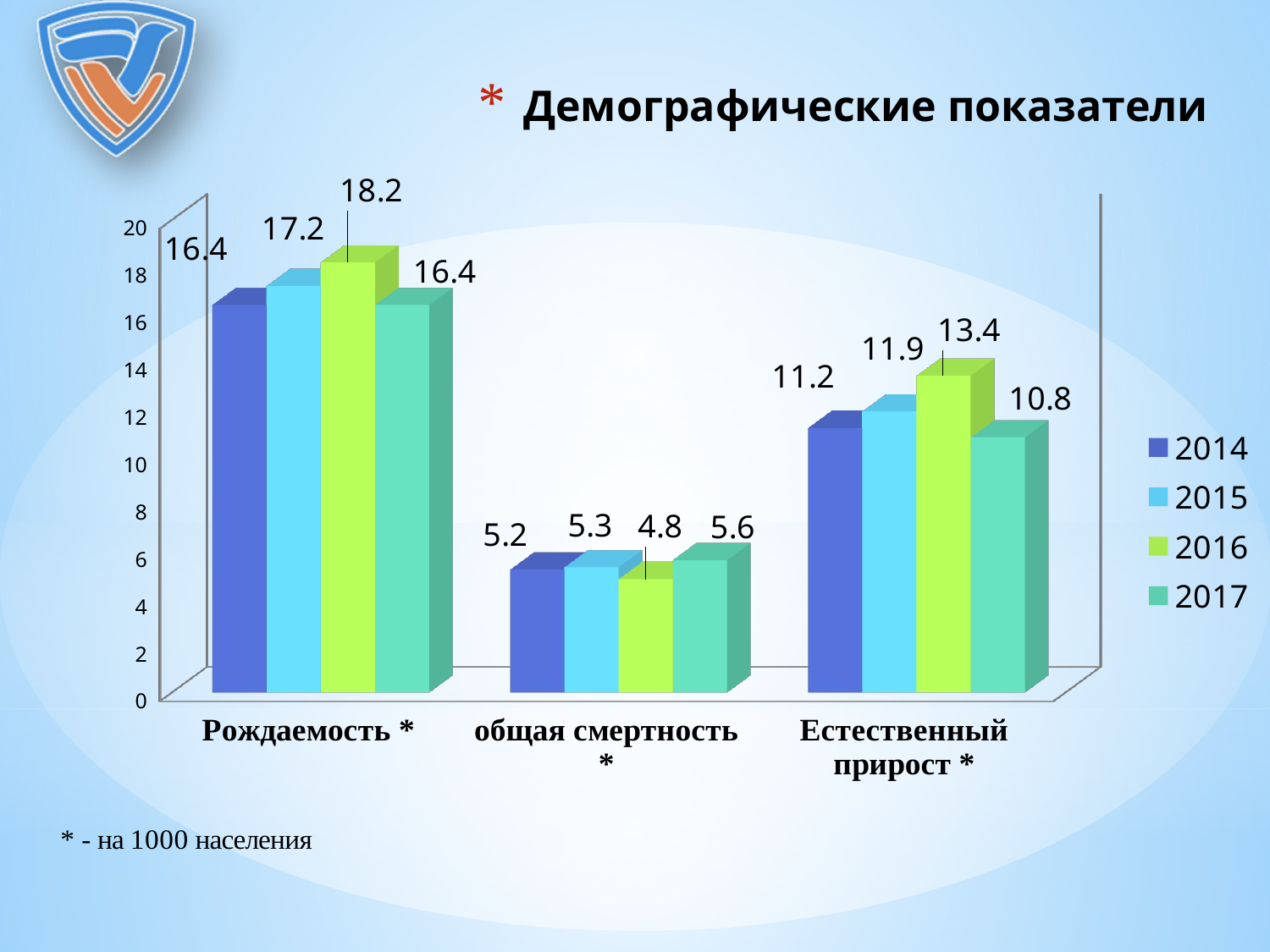
How many categories are shown on the x axis? 3 How many series does the legend list? 4 What kind of chart is shown on the slide? bar chart Which year has the highest value for Естественный прирост *? 2016 What is the difference between the 2016 and 2017 values for Рождаемость *? 1.8 What is the difference between the 2016 and 2014 values for Естественный прирост *? 2.2 Which year has the lowest value for общая смертность *? 2016 What is the title of the slide? Демографические показатели What is the value for общая смертность * in 2017? 5.6 Which is larger: the 2015 value for Естественный прирост * or the 2017 value for Естественный прирост *? 2015 What is the value for Рождаемость * in 2016? 18.2 What is the value for Естественный прирост * in 2014? 11.2